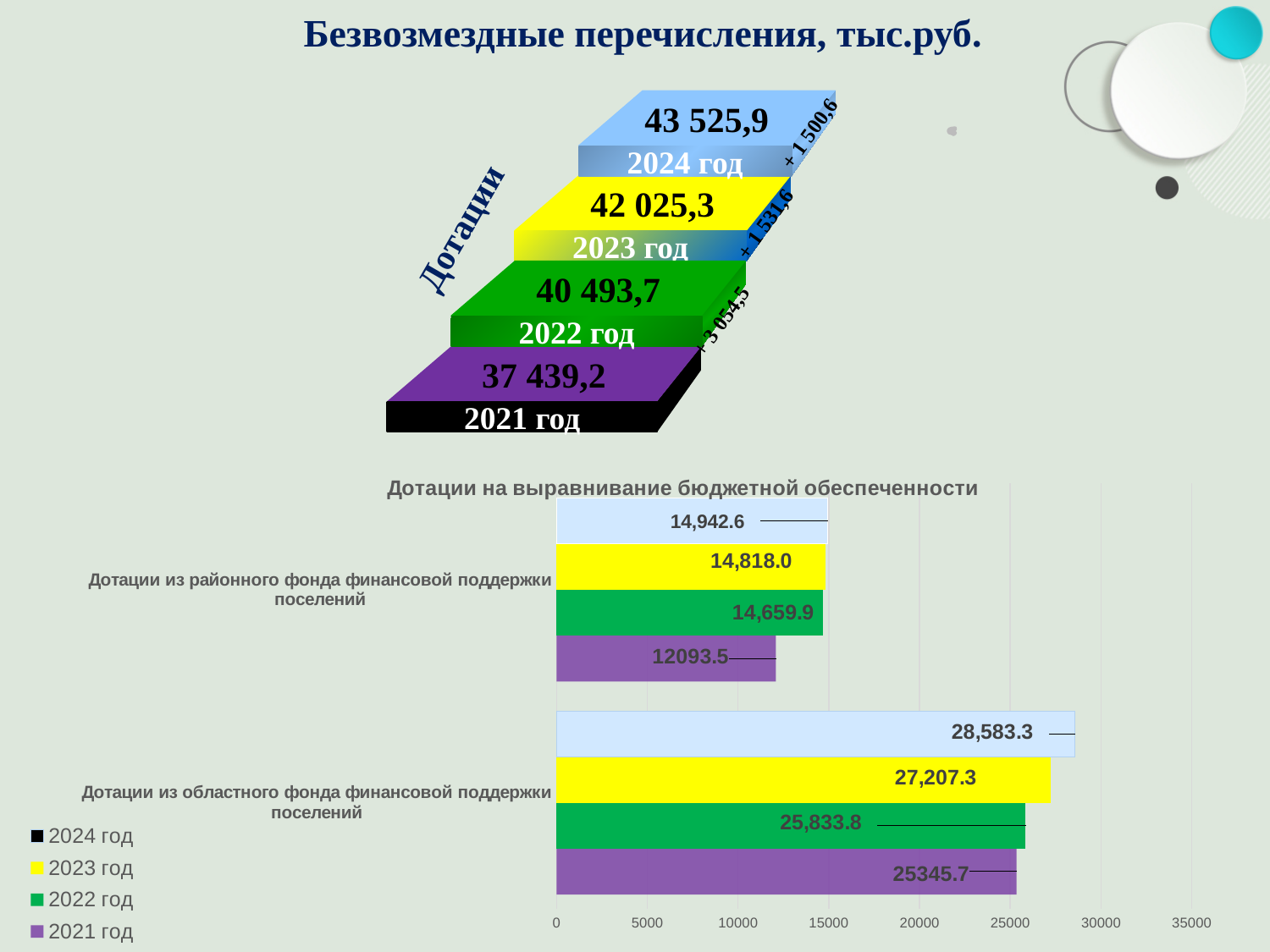
How many series does the legend of the bottom chart list? 4 In the top chart 'Дотации', do the values rise or fall from 2021 to 2024? rise In the bottom chart 'Дотации на выравнивание бюджетной обеспеченности', is the 2021 год value for 'Дотации из областного фонда финансовой поддержки поселений' greater or less than 25000? greater In the top chart 'Дотации', which year has the lowest value? 2021 год In the bottom chart 'Дотации на выравнивание бюджетной обеспеченности', what is the value for 2023 год for 'Дотации из областного фонда финансовой поддержки поселений'? 27,207.3 In the top chart 'Дотации', what is the value shown for 2021 год? 37 439,2 In the bottom chart 'Дотации на выравнивание бюджетной обеспеченности', what is the difference between the 2024 год and 2023 год values for 'Дотации из областного фонда финансовой поддержки поселений'? 1,376.0 In the top chart 'Дотации', what is the value shown for 2024 год? 43 525,9 In the bottom chart 'Дотации на выравнивание бюджетной обеспеченности', which is larger for 2022 год: 'Дотации из районного фонда' or 'Дотации из областного фонда'? Дотации из областного фонда финансовой поддержки поселений In the bottom chart 'Дотации на выравнивание бюджетной обеспеченности', what is the value for 2021 год for 'Дотации из районного фонда финансовой поддержки поселений'? 12093.5 In the bottom chart 'Дотации на выравнивание бюджетной обеспеченности', which year has the highest value for 'Дотации из областного фонда финансовой поддержки поселений'? 2024 год What kind of chart is the bottom chart 'Дотации на выравнивание бюджетной обеспеченности'? bar chart